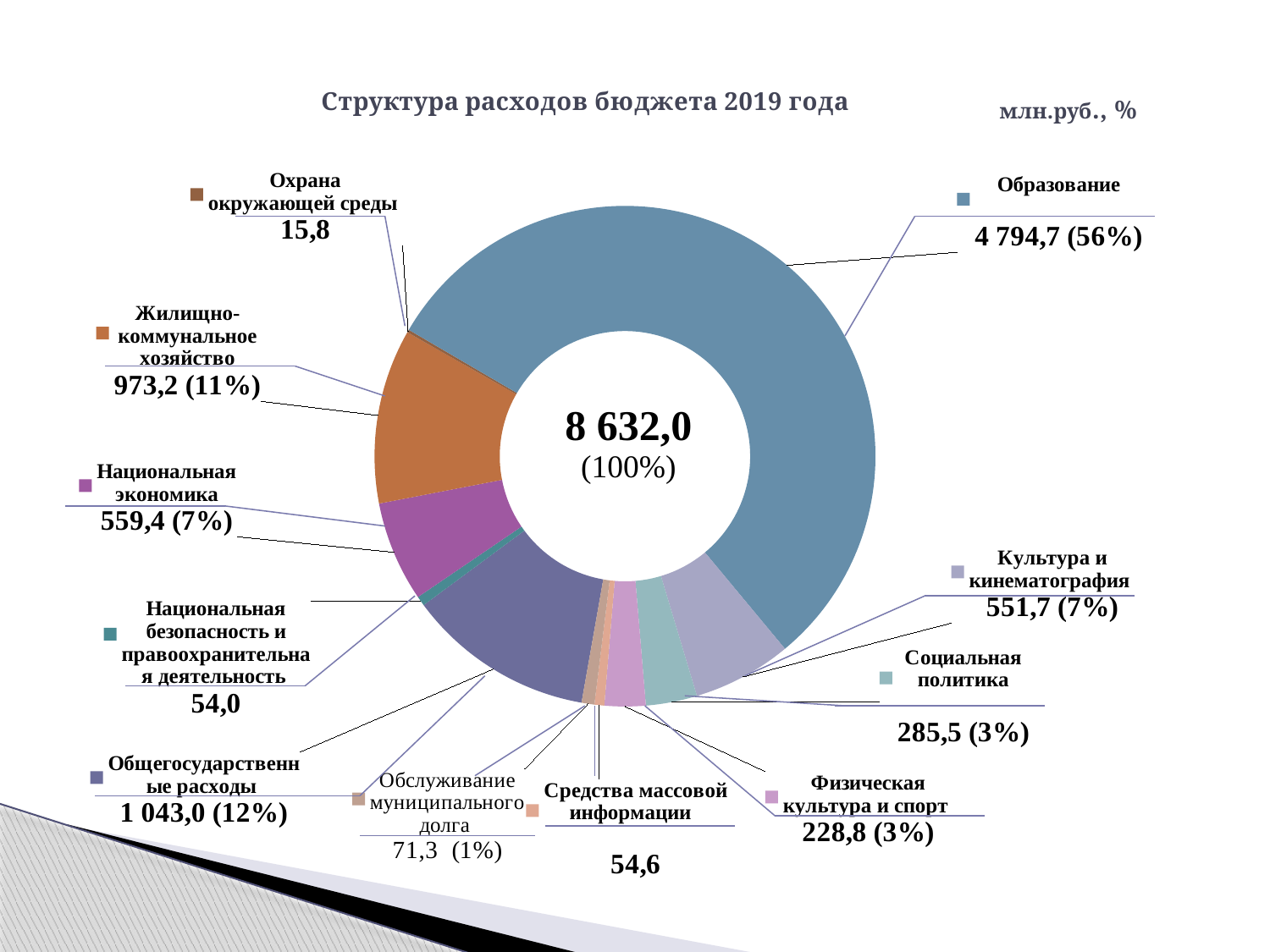
Which is larger, Общегосударственные расходы or Жилищно-коммунальное хозяйство? Общегосударственные расходы What share of the budget expenditure does Образование account for? 56% How many expenditure categories are shown on the chart? 11 What is the difference between Социальная политика and Физическая культура и спорт? 56,7 What kind of chart is shown on the slide? Doughnut chart Which category has the smallest value? Охрана окружающей среды What is the value for Охрана окружающей среды? 15,8 What is the total shown in the centre of the chart? 8 632,0 What is the value for Жилищно-коммунальное хозяйство? 973,2 What is the value for Образование? 4 794,7 What is the title of the chart? Структура расходов бюджета 2019 года Which category has the largest share of expenditure? Образование